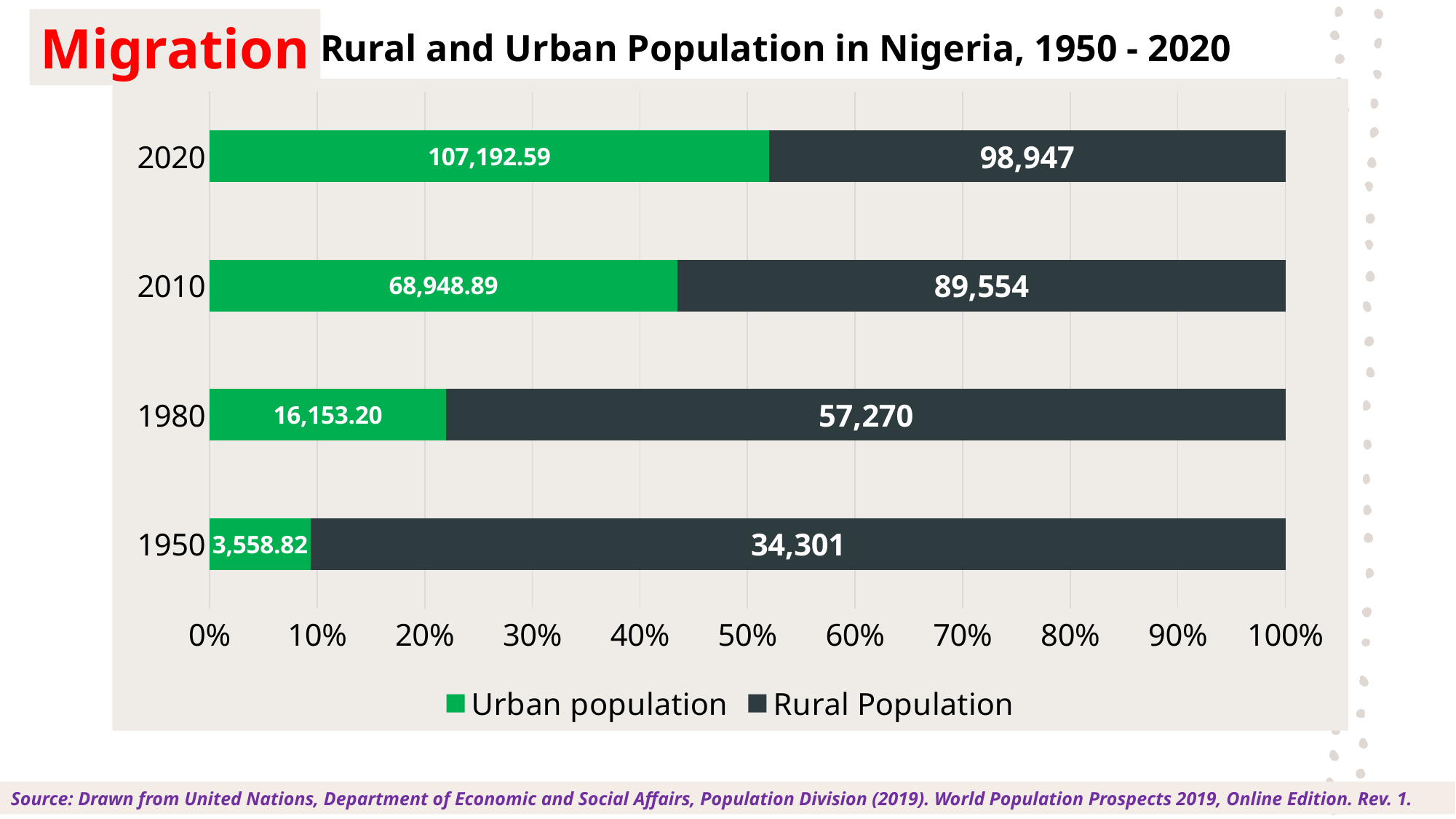
Is the Urban population share of the 2010 bar greater or less than 50%? less How many years are shown on the chart? 4 How many series does the legend list? 2 Which year has the lowest Urban population value? 1950 Does the Urban population value rise or fall from 1950 to 2020? Rise Which year has the highest Rural Population value? 2020 What is the Urban population value shown for 2020? 107,192.59 What kind of chart is shown on the slide? Stacked bar chart What is the Rural Population value shown for 1980? 57,270 What is the Urban population value shown for 1950? 3,558.82 In 2010, which is larger, the Urban population or the Rural Population? Rural Population What is the difference between the Rural Population values for 2010 and 1980? 32,284